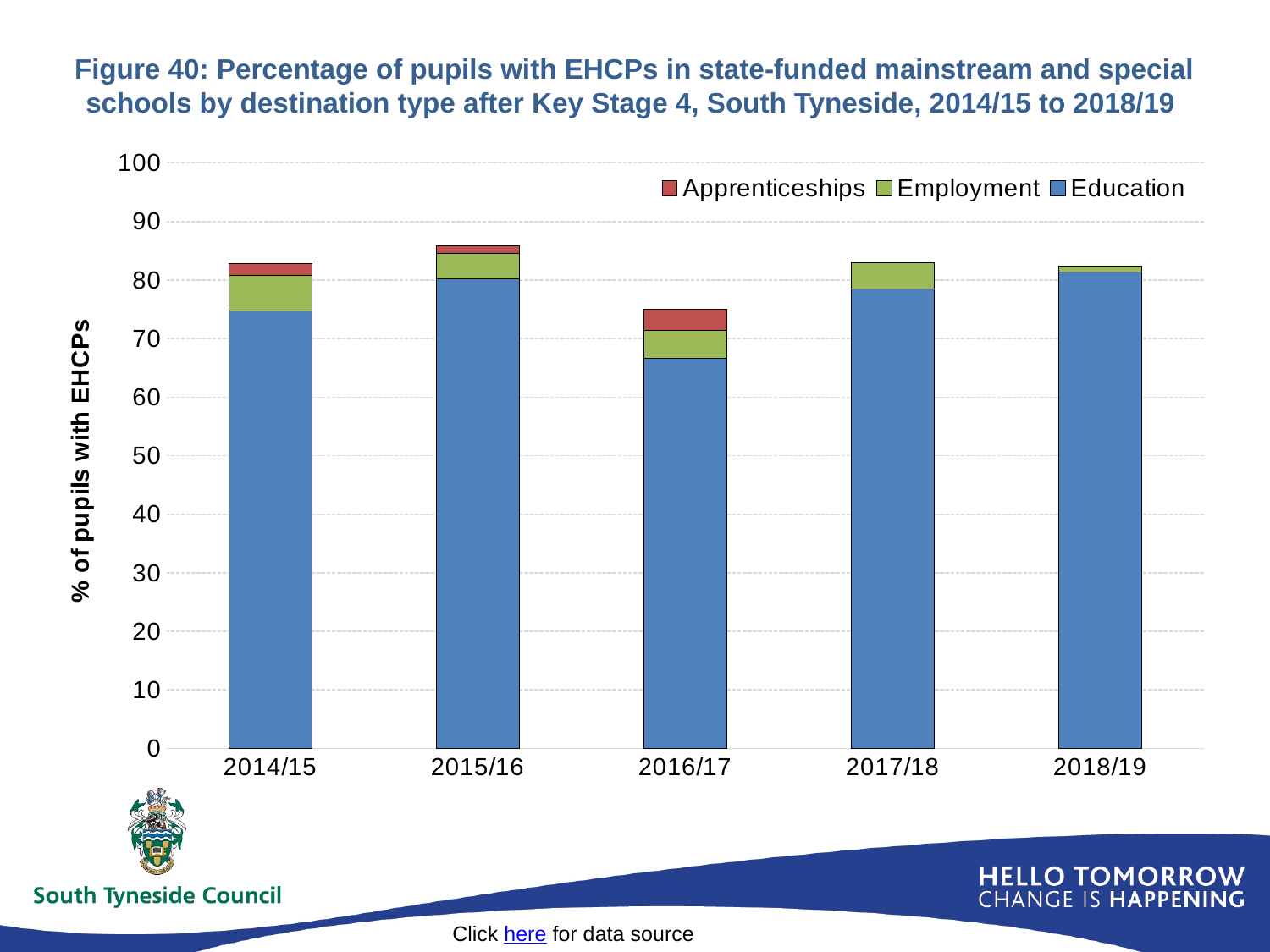
In which year is the total height of the stacked bar highest? 2015/16 Is the Education value for 2014/15 greater or less than 80? less How many series does the legend list? 3 What is the label on the y axis? % of pupils with EHCPs How many academic years are shown on the x axis? 5 What kind of chart is shown on the slide? Stacked bar chart In which year is the total height of the stacked bar lowest? 2016/17 Is the Education value for 2016/17 greater or less than 70? less Which series are listed in the legend? Apprenticeships, Employment, Education Which year has the larger Apprenticeships segment, 2015/16 or 2016/17? 2016/17 In which year is the Education segment lowest? 2016/17 Is the total of the stacked bar for 2015/16 greater or less than 90? less